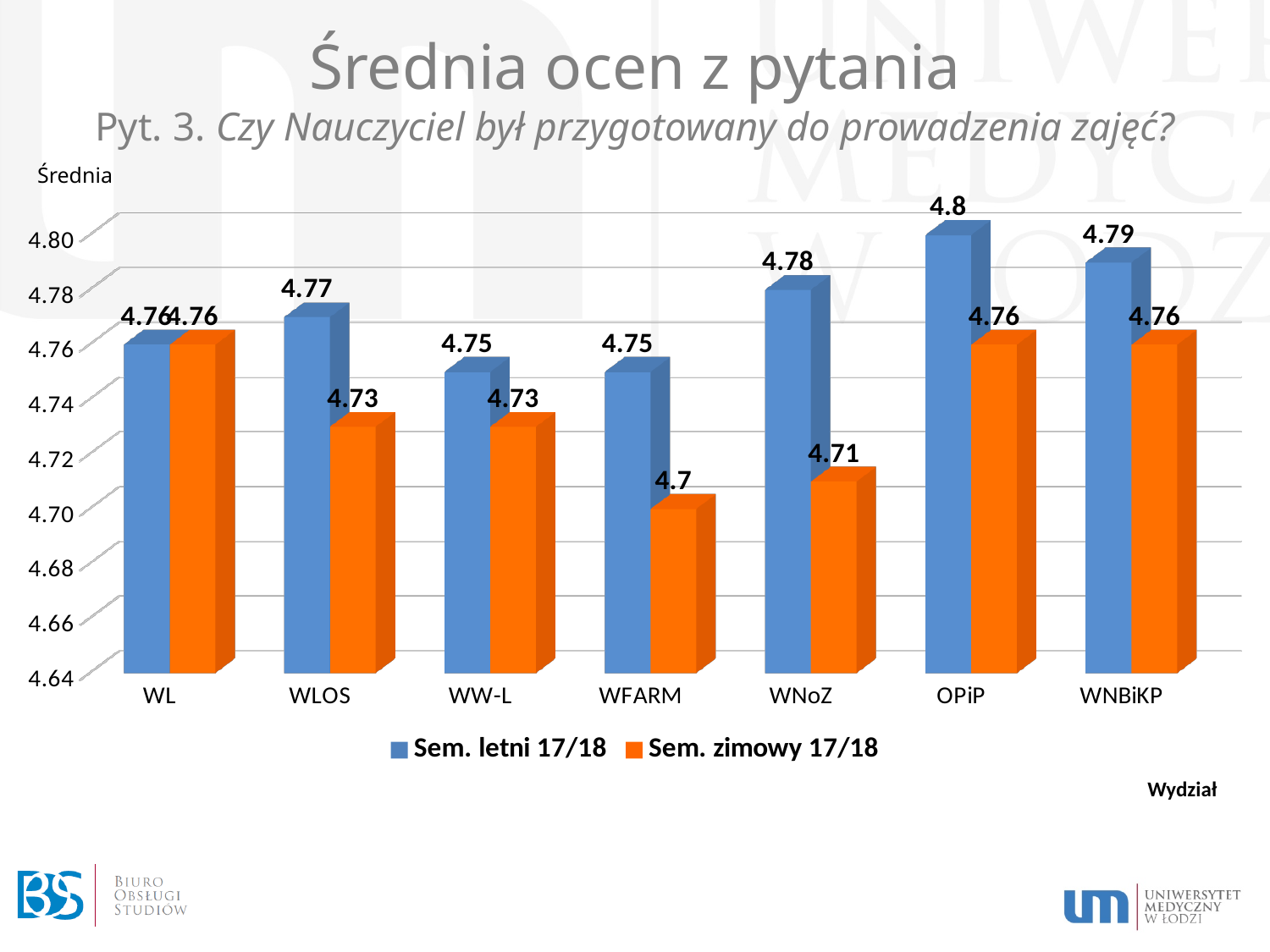
Which colour represents the Sem. zimowy 17/18 series? orange Which category has the lowest value in the Sem. zimowy 17/18 series? WFARM What is the value for WNoZ in the Sem. zimowy 17/18 series? 4.71 What is the difference between the Sem. letni 17/18 and Sem. zimowy 17/18 values for OPiP? 0.04 What kind of chart is shown on the slide? bar chart Which category has the highest value in the Sem. letni 17/18 series? OPiP What is the difference between the Sem. letni 17/18 and Sem. zimowy 17/18 values for WNoZ? 0.07 How many series does the legend list? 2 How many categories (faculties) are shown on the x axis? 7 What is the value for OPiP in the Sem. letni 17/18 series? 4.8 Which is larger for WLOS: the Sem. letni 17/18 value or the Sem. zimowy 17/18 value? Sem. letni 17/18 What is the value for WFARM in the Sem. zimowy 17/18 series? 4.7